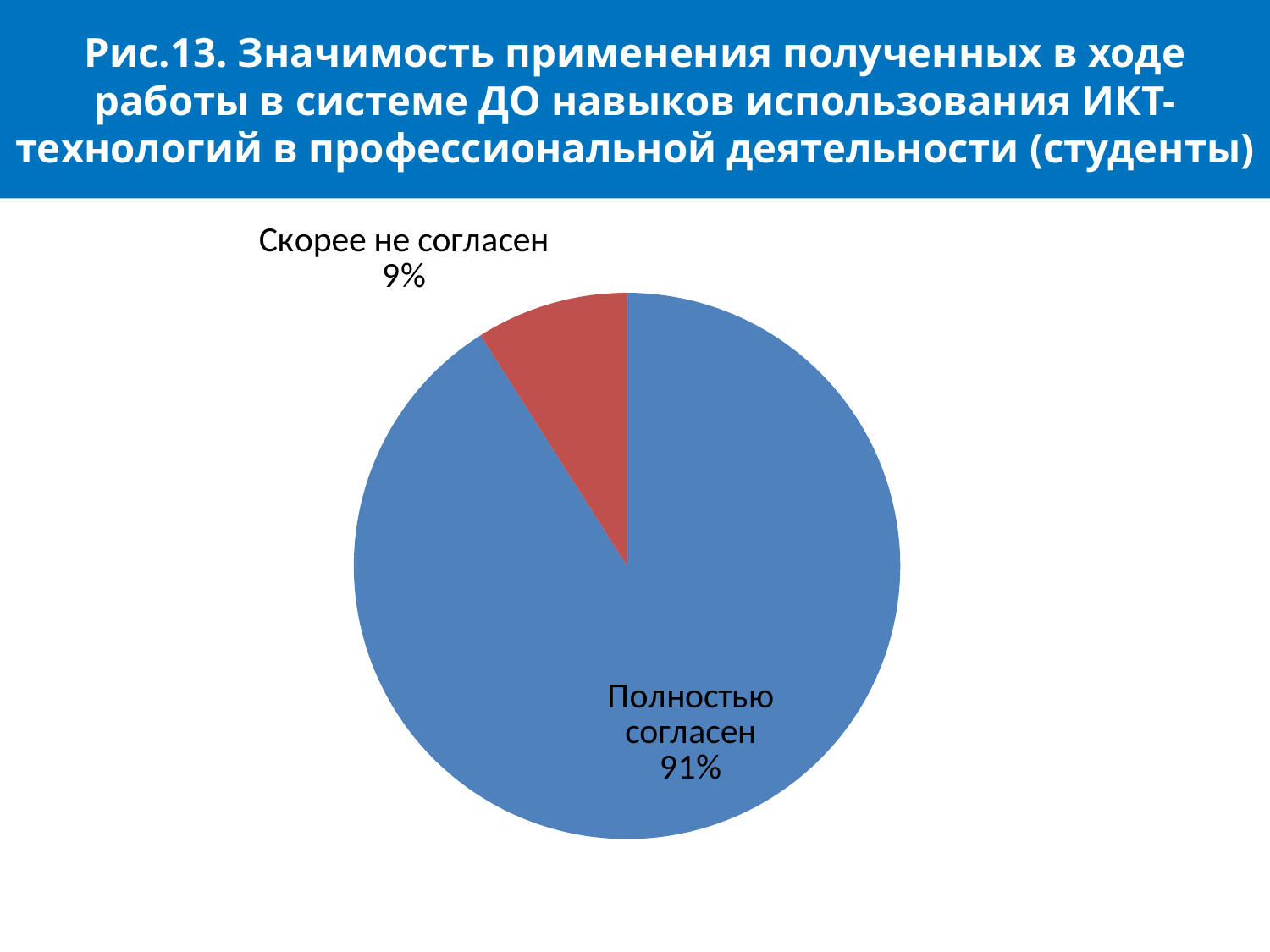
What colour is the slice for "Полностью согласен"? blue How many slices does the pie chart have? 2 What kind of chart is shown on the slide? pie chart What colour is the slice for "Скорее не согласен"? red What is the difference in percentage points between "Полностью согласен" and "Скорее не согласен"? 82 Which is larger: the share for "Полностью согласен" or for "Скорее не согласен"? Полностью согласен What share of the pie is labelled "Скорее не согласен"? 9% Which category has the largest slice of the pie? Полностью согласен Which category has the smallest slice of the pie? Скорее не согласен What share of the pie is labelled "Полностью согласен"? 91%